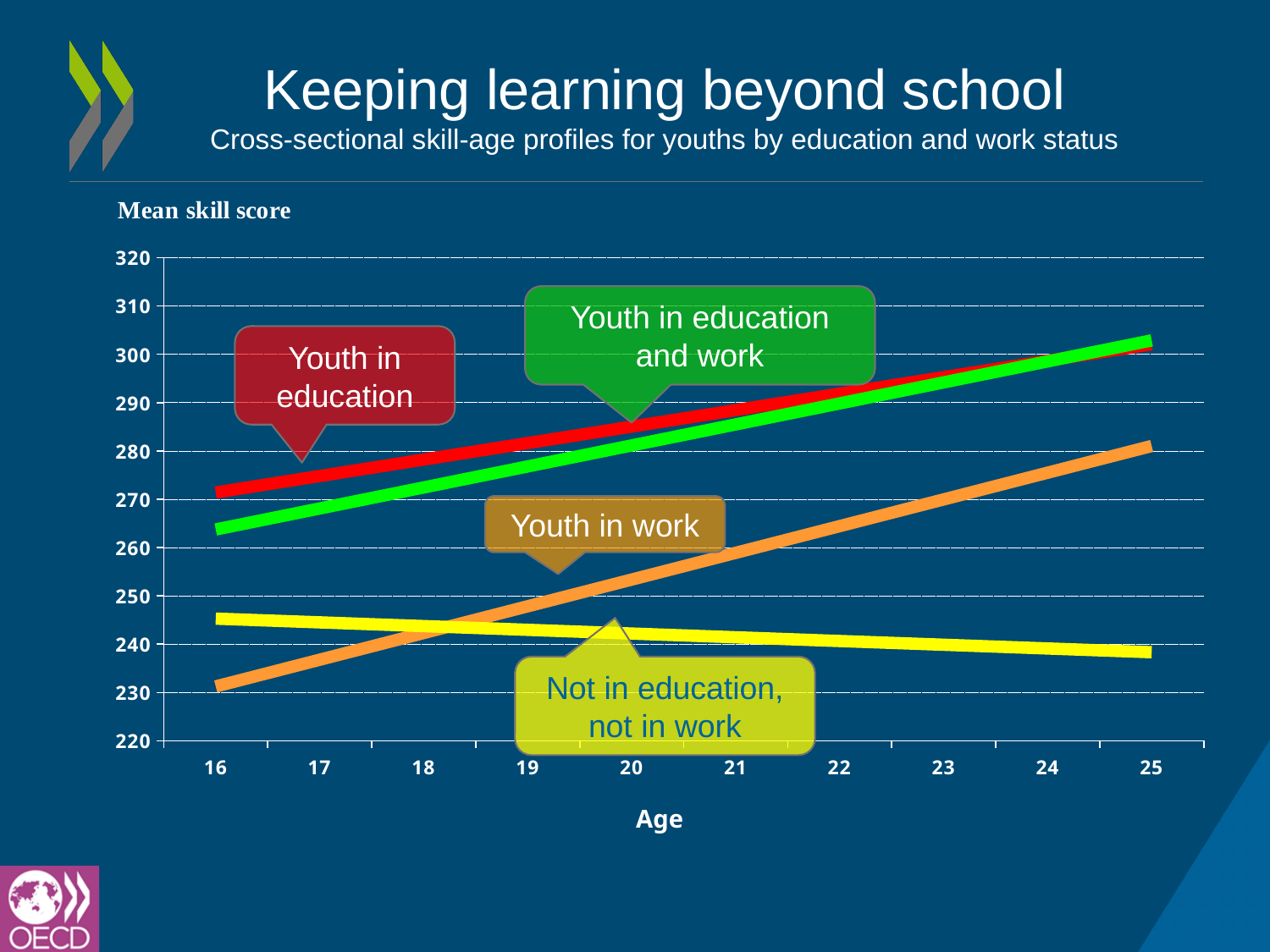
Is the value for Not in education, not in work at age 25 greater or less than 250? less What is the label of the x axis of the chart? Age Is the value for Youth in education and work at age 16 greater or less than 270? less Which group has the lowest mean skill score at age 25? Not in education, not in work How many age values are marked along the x axis of the chart? 10 What kind of chart is shown on the slide? line chart Does the line for Not in education, not in work rise or fall as age increases? fall Is the value for Youth in work at age 16 greater or less than 240? less At age 16, which group has the higher mean skill score: Youth in education or Youth in work? Youth in education Does the mean skill score for Youth in education rise or fall as age increases from 16 to 25? rise How many groups (lines) are plotted on the chart? 4